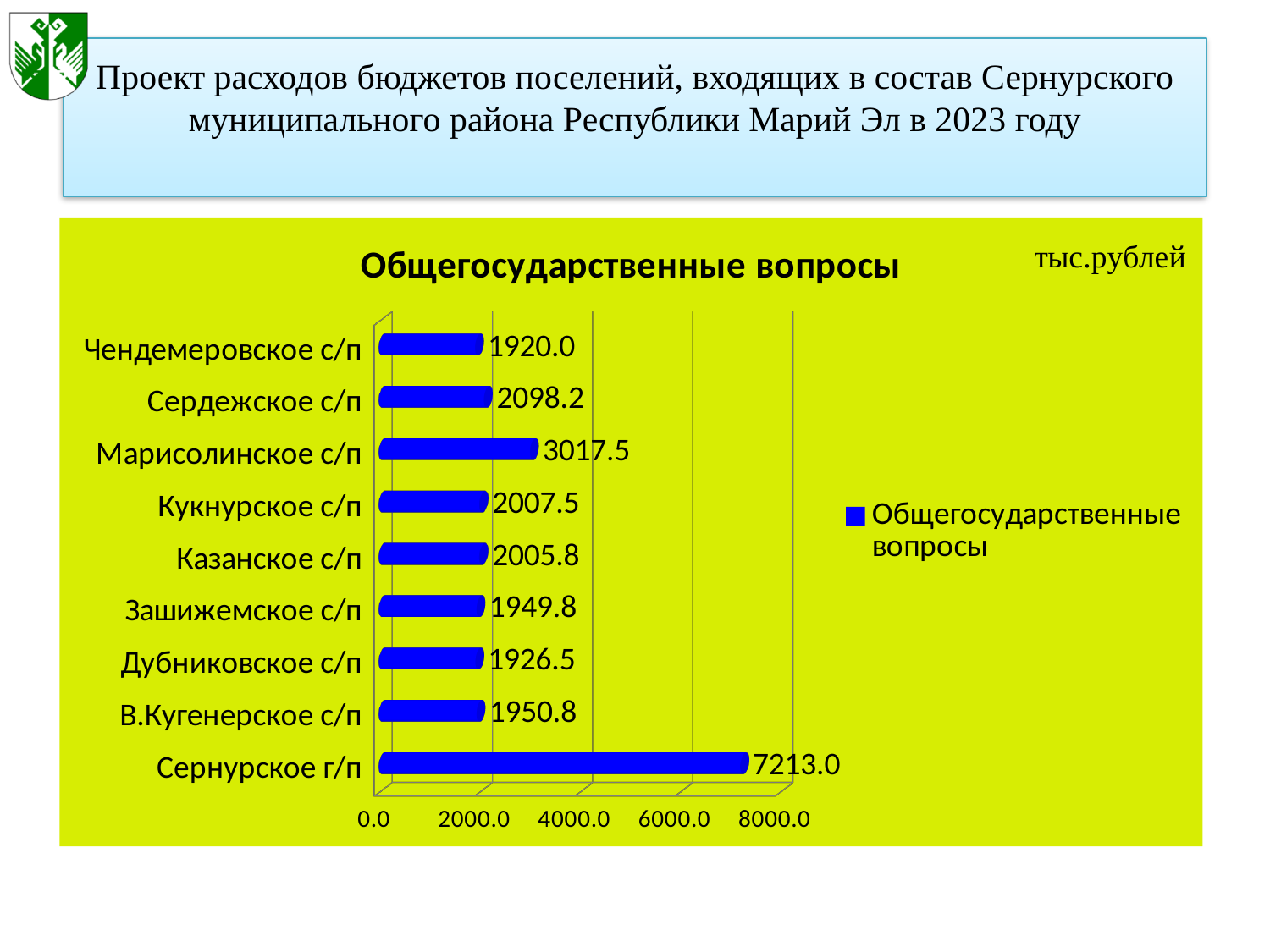
What is the value for Марисолинское с/п? 3017.5 What is the difference between the values for Сернурское г/п and Марисолинское с/п? 4195.5 Which is larger, the value for Марисолинское с/п or for Сердежское с/п? Марисолинское с/п What is the title of the chart? Общегосударственные вопросы Which settlement has the highest value? Сернурское г/п What kind of chart is shown on the slide? bar chart Is the value for Сернурское г/п greater or less than 6000.0? greater How many series does the legend list? 1 Which settlement has the lowest value? Чендемеровское с/п How many settlements are shown in the chart? 9 What is the value for Сернурское г/п? 7213.0 What is the value for Казанское с/п? 2005.8